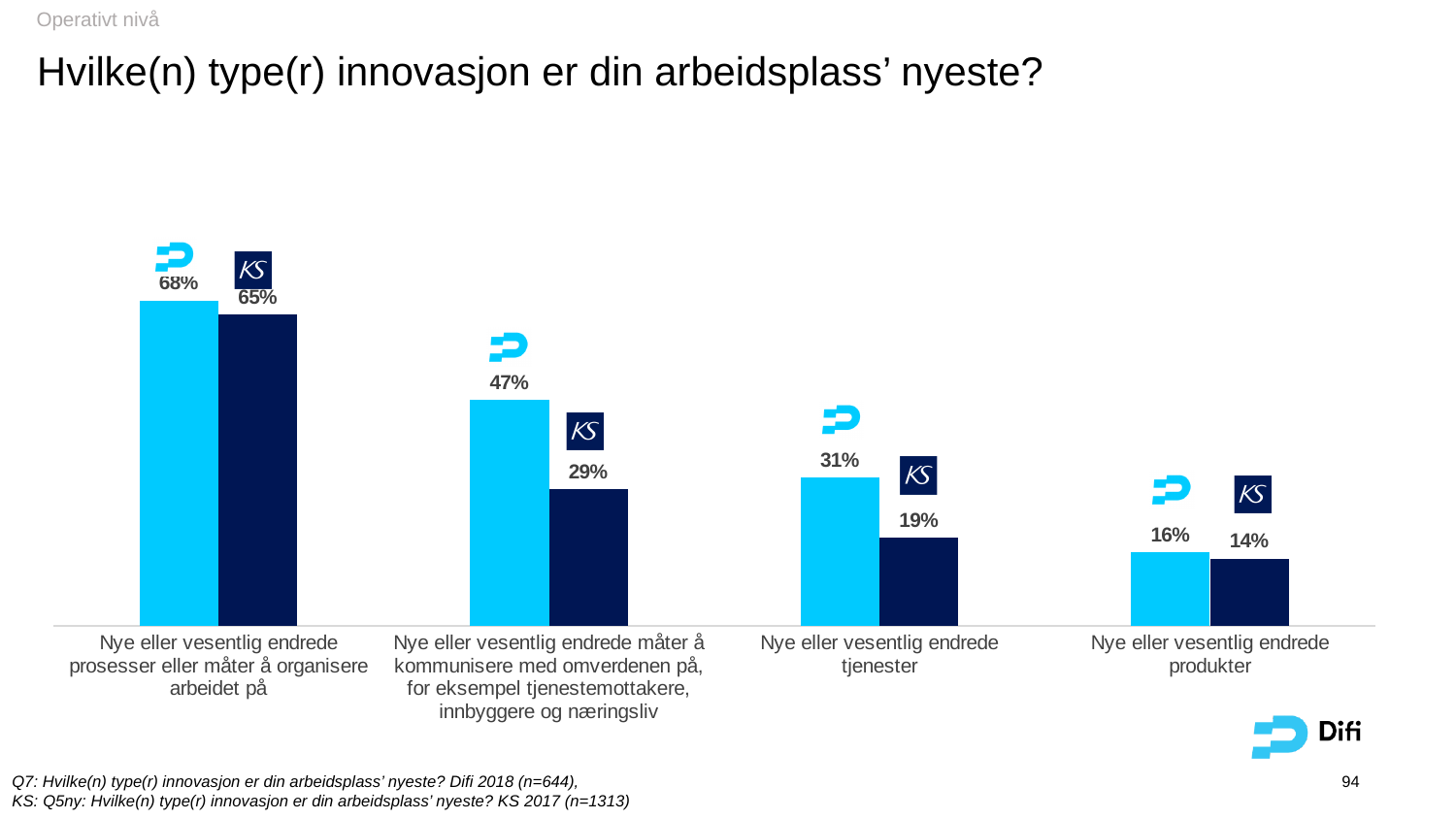
Which is larger for 'Nye eller vesentlig endrede prosesser eller måter å organisere arbeidet på': the Difi value or the KS value? Difi What is the Difi value for 'Nye eller vesentlig endrede produkter'? 16% Which category has the lowest KS value? Nye eller vesentlig endrede produkter How many series does the chart show? 2 What kind of chart is shown on the slide? Bar chart Which category has the highest Difi value? Nye eller vesentlig endrede prosesser eller måter å organisere arbeidet på What is the KS value for 'Nye eller vesentlig endrede tjenester'? 19% What is the KS value for 'Nye eller vesentlig endrede måter å kommunisere med omverdenen på, for eksempel tjenestemottakere, innbyggere og næringsliv'? 29% What is the difference between the Difi and KS values for 'Nye eller vesentlig endrede tjenester'? 12 percentage points How many categories are shown on the x axis? 4 What is the difference between the Difi and KS values for 'Nye eller vesentlig endrede måter å kommunisere med omverdenen på'? 18 percentage points What is the Difi value for 'Nye eller vesentlig endrede prosesser eller måter å organisere arbeidet på'? 68%